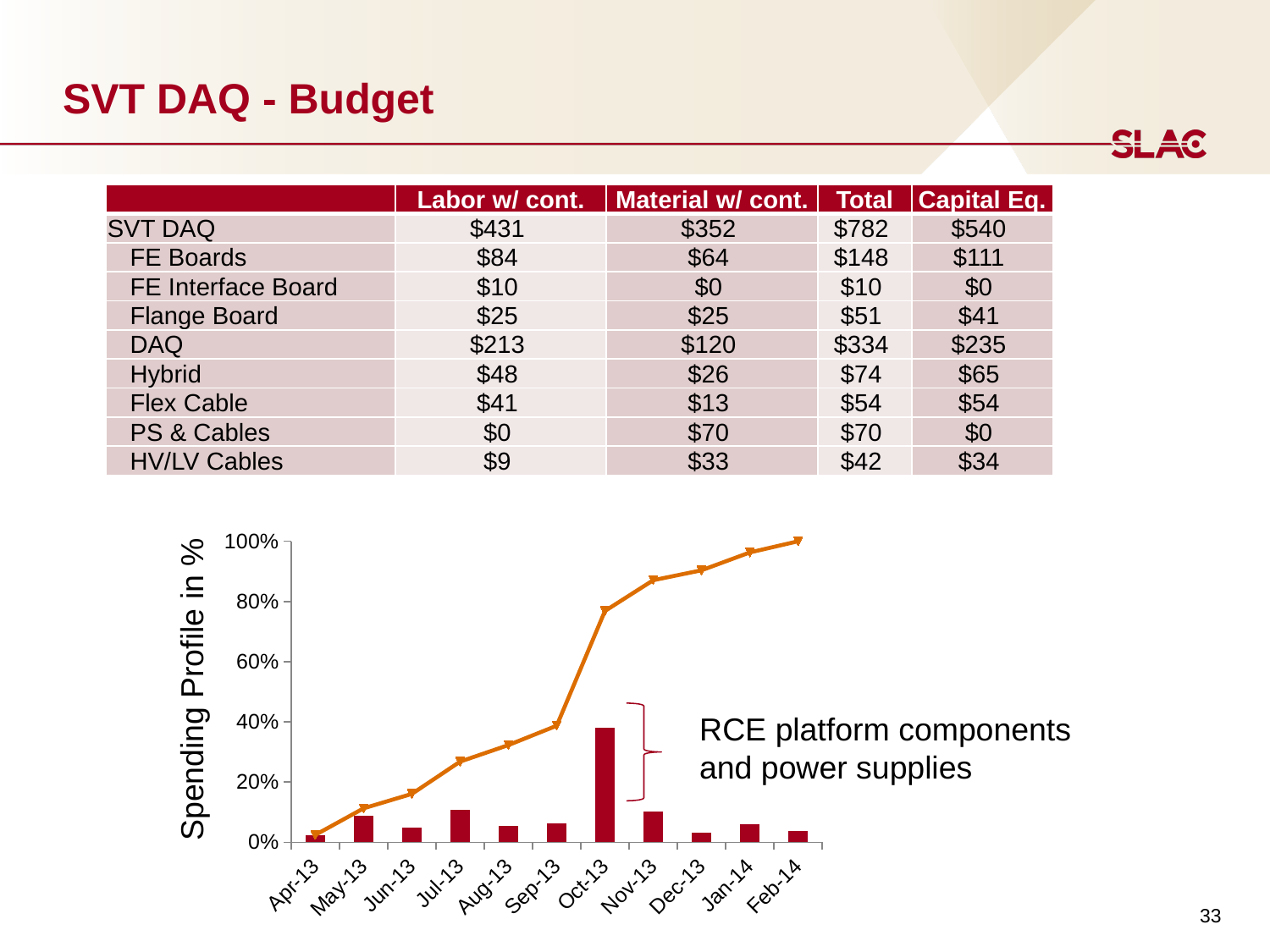
Does the line in the spending profile chart rise or fall from Apr-13 to Feb-14? rise Which bar is taller, Oct-13 or Nov-13? Oct-13 Is the line value for Nov-13 greater or less than 80%? greater What does the annotation next to the Oct-13 bar say? RCE platform components and power supplies Is the line value for Aug-13 greater or less than 40%? less Which month has the tallest bar in the spending profile chart? Oct-13 What value does the line reach at Feb-14? 100% What is the label on the y axis of the chart? Spending Profile in % What kind of chart is shown at the bottom of the slide? A bar chart combined with a line Is the bar for Oct-13 greater or less than 20%? greater How many months are shown on the x axis of the spending profile chart? 11